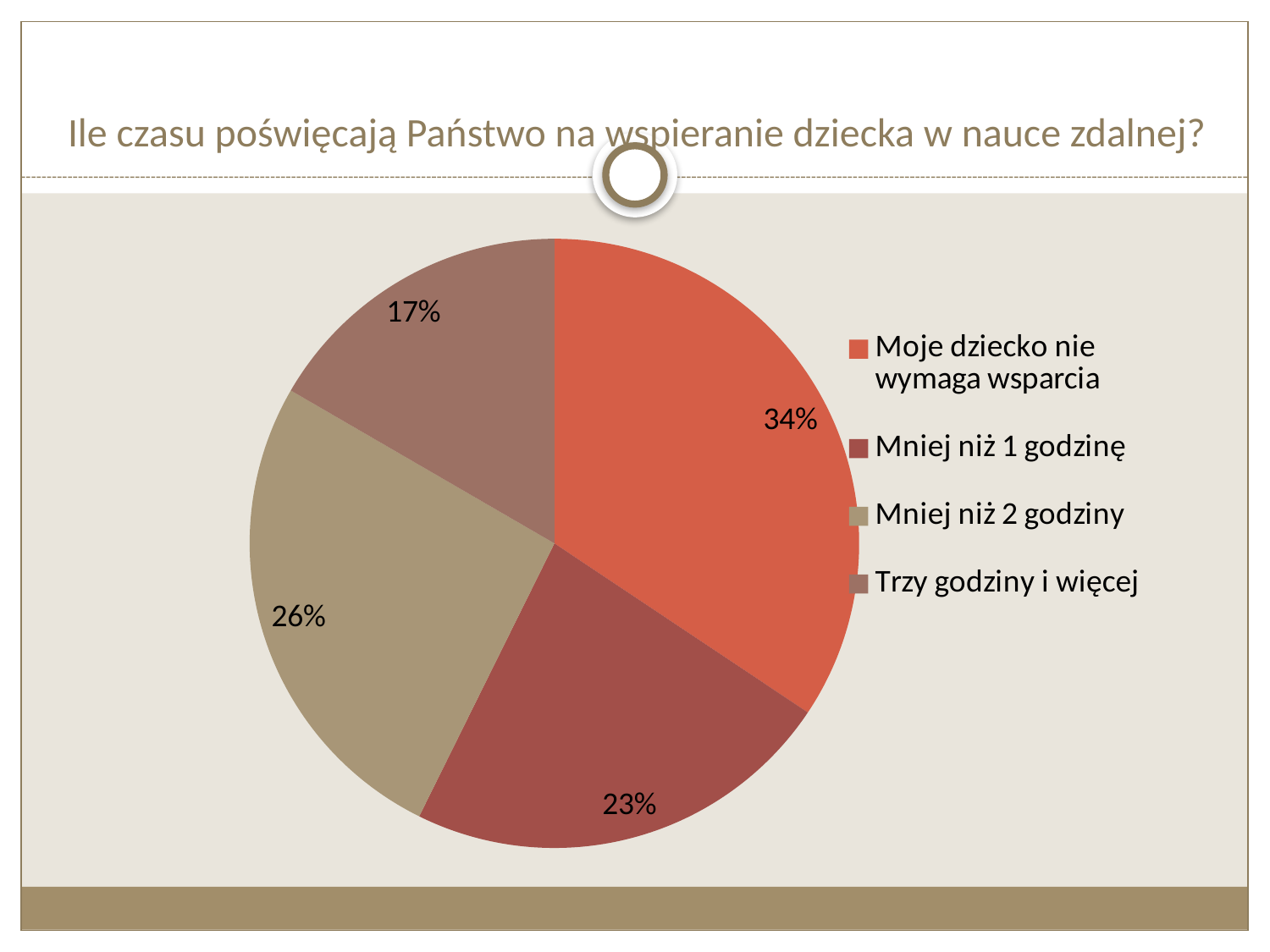
What is the title of the slide above the chart? Ile czasu poświęcają Państwo na wspieranie dziecka w nauce zdalnej? How many categories does the pie chart have? 4 Which category has the smallest slice of the pie? Trzy godziny i więcej What share of the pie is labelled "Moje dziecko nie wymaga wsparcia"? 34% What share of the pie is labelled "Trzy godziny i więcej"? 17% What kind of chart is shown on the slide? pie chart Which is larger: the slice for "Mniej niż 2 godziny" or the slice for "Mniej niż 1 godzinę"? Mniej niż 2 godziny What share of the pie is labelled "Mniej niż 2 godziny"? 26% Which legend entry is shown in the orange-red colour? Moje dziecko nie wymaga wsparcia Which category has the largest slice of the pie? Moje dziecko nie wymaga wsparcia What share of the pie is labelled "Mniej niż 1 godzinę"? 23% What is the difference in percentage points between "Moje dziecko nie wymaga wsparcia" and "Trzy godziny i więcej"? 17